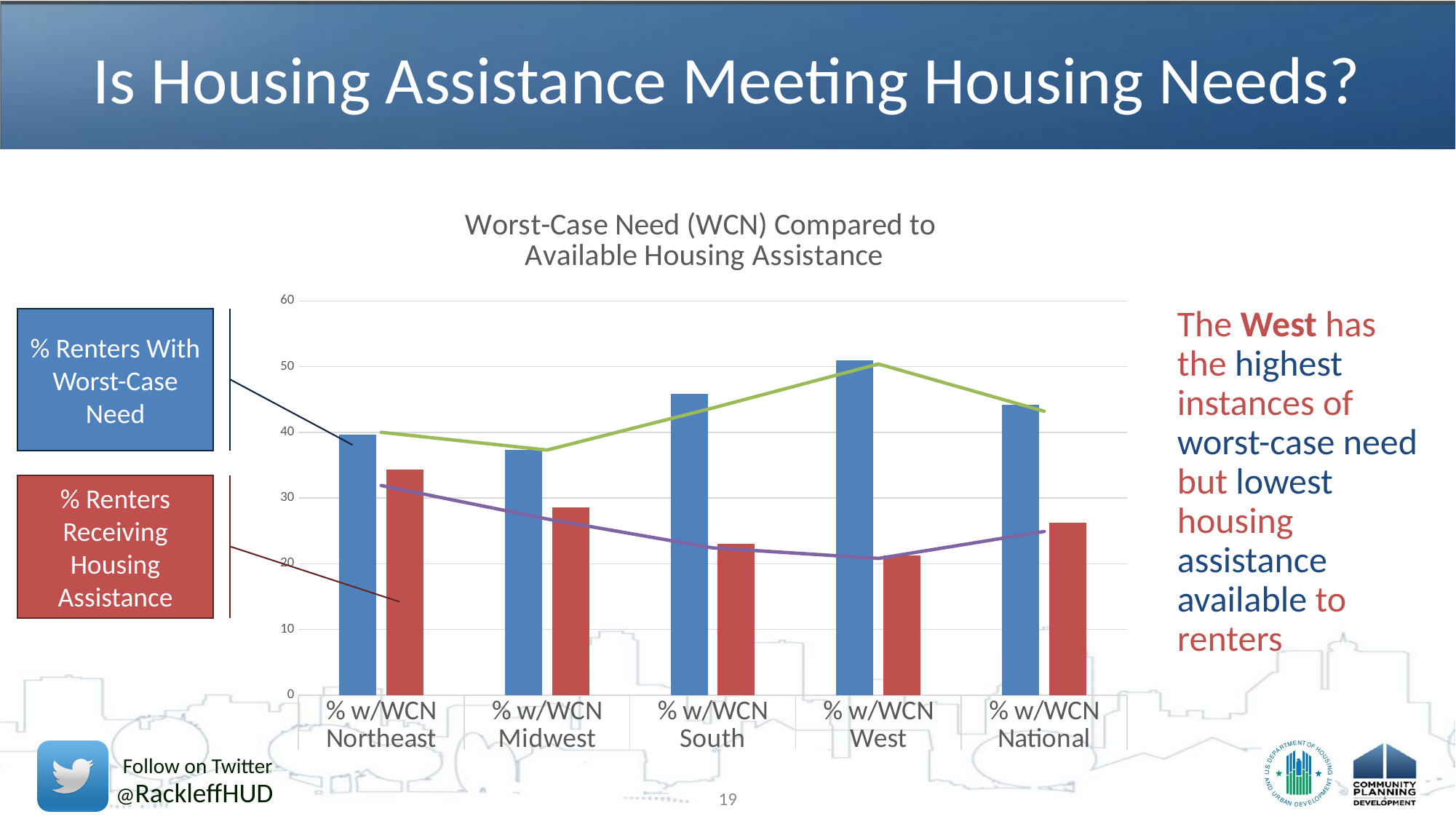
Which category has the lowest value for % Renters With Worst-Case Need? Midwest Which category has the highest value for % Renters With Worst-Case Need? West What colour are the bars for % Renters Receiving Housing Assistance? red What is the title of the chart? Worst-Case Need (WCN) Compared to Available Housing Assistance How many regional categories are shown along the x axis of the chart? 5 What kind of chart is shown on the slide? combination bar and line chart Does the % Renters Receiving Housing Assistance rise or fall from Northeast to West? fall Which is larger in the Northeast: % Renters With Worst-Case Need or % Renters Receiving Housing Assistance? % Renters With Worst-Case Need Which category has the highest value for % Renters Receiving Housing Assistance? Northeast Which category has the lowest value for % Renters Receiving Housing Assistance? West Is the value for % Renters With Worst-Case Need in the West greater or less than 50? greater Is the value for % Renters Receiving Housing Assistance in the South greater or less than 30? less